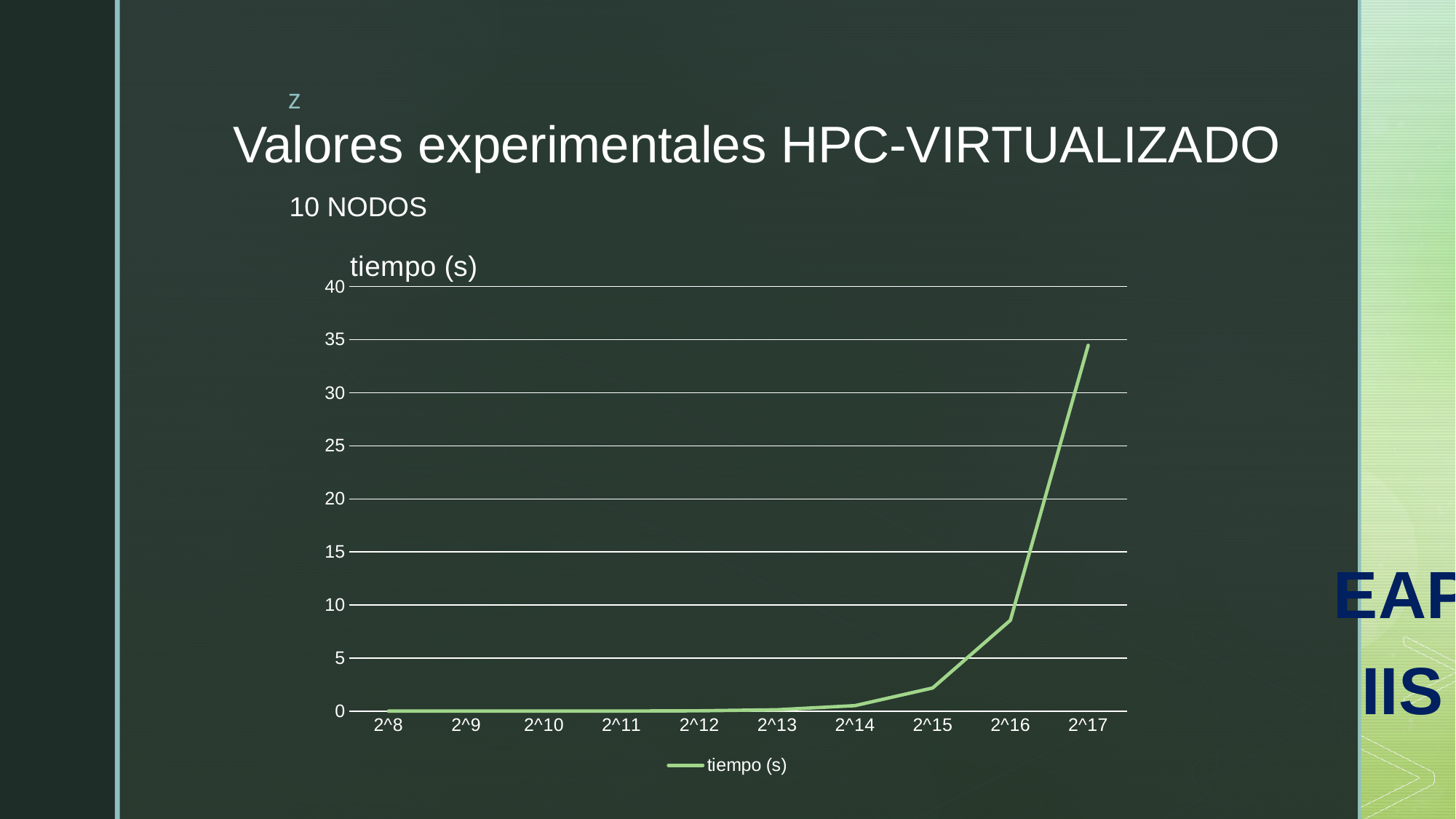
What is the name of the series shown in the legend? tiempo (s) Is the value for 2^17 greater or less than 30? greater Which category has the highest value for tiempo (s)? 2^17 Which has a larger value, 2^16 or 2^17? 2^17 How many categories are plotted along the x axis? 10 How many series does the legend list? 1 Is the value for 2^16 greater or less than 10? less Is the value for 2^15 greater or less than 5? less What kind of chart is shown on the slide? line chart What is the title of the chart? tiempo (s) Do the values rise or fall as the x axis goes from 2^8 to 2^17? rise